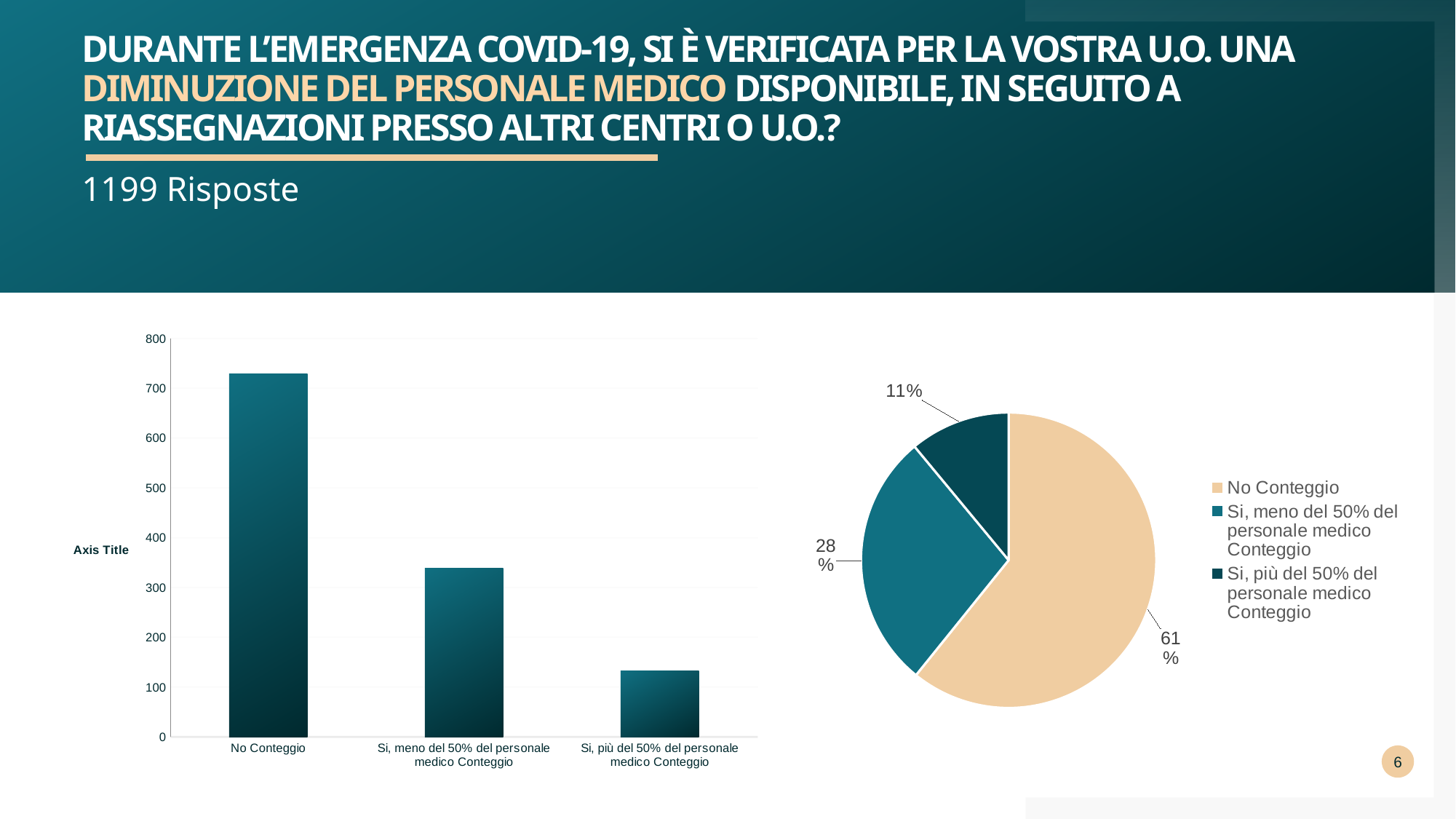
In the pie chart on the right, what share is labelled for No Conteggio? 61% What kind of chart is on the left side of the slide? bar chart In the bar chart on the left, how many categories are shown? 3 In the pie chart on the right, what is the difference in percentage points between the No Conteggio slice and the Si, meno del 50% del personale medico Conteggio slice? 33 In the bar chart on the left, is the value for Si, meno del 50% del personale medico Conteggio greater or less than 400? less In the pie chart on the right, what share is labelled for Si, più del 50% del personale medico Conteggio? 11% In the bar chart on the left, is the value for Si, più del 50% del personale medico Conteggio greater or less than 100? greater How many entries does the legend of the pie chart on the right list? 3 In the bar chart on the left, is the value for No Conteggio greater or less than 700? greater What kind of chart is on the right side of the slide? pie chart In the bar chart on the left, which category has the highest bar? No Conteggio In the bar chart on the left, which category has the lowest bar? Si, più del 50% del personale medico Conteggio